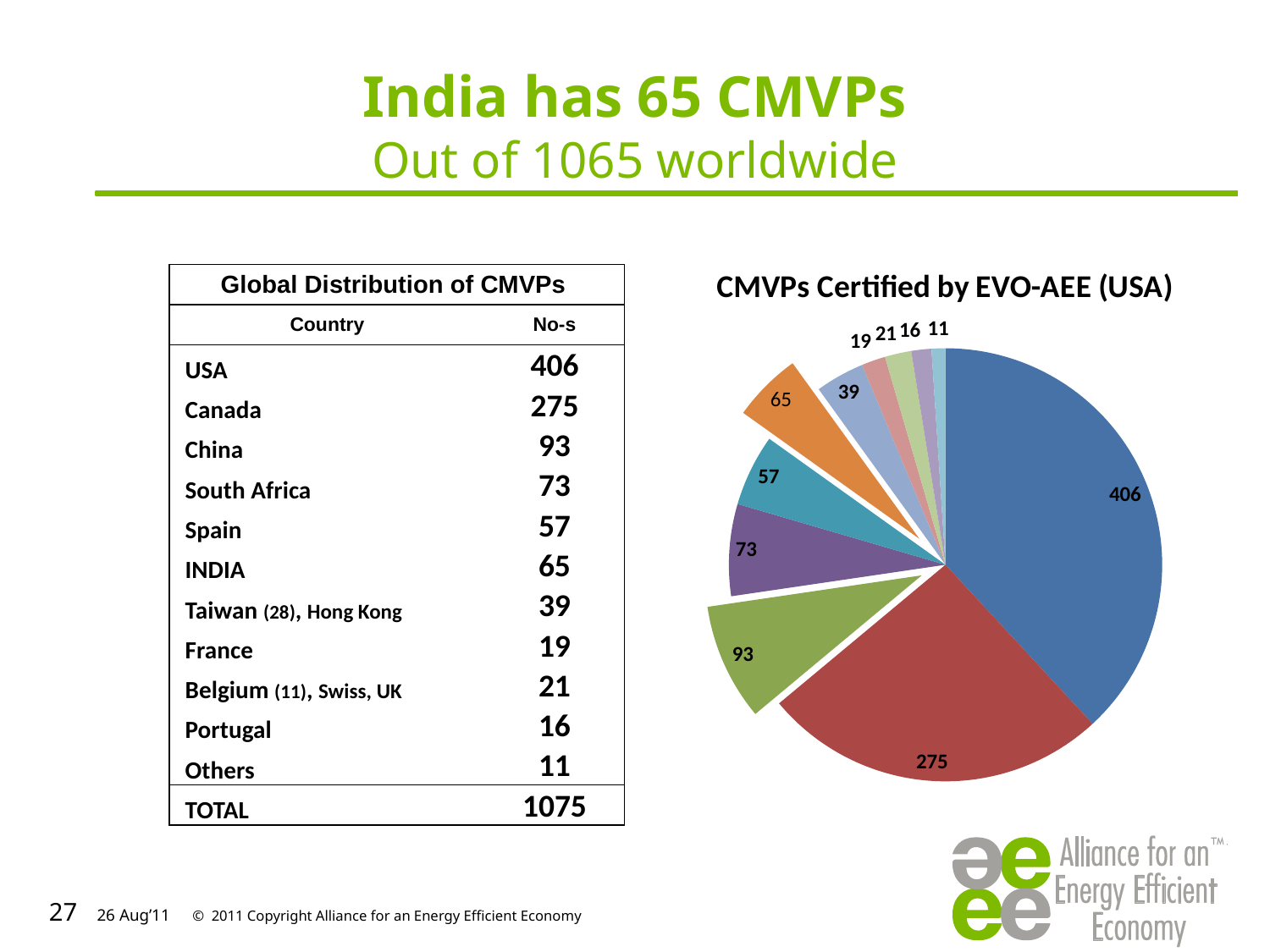
What is the value of the largest slice in the pie chart? 406 What kind of chart is shown on the slide? pie chart How many slices does the pie chart have? 11 What is the value of the second-largest slice in the pie chart? 275 What is the value of the smallest slice in the pie chart? 11 What is the difference between the slices labelled 65 and 57 in the pie chart? 8 What share of the pie does the slice labelled 406 represent, to one decimal place? 37.8% What is the title of the pie chart? CMVPs Certified by EVO-AEE (USA) What is the total of all slice values in the pie chart? 1075 Which slice is larger in the pie chart, the one labelled 93 or the one labelled 73? 93 What is the difference between the two largest slices in the pie chart (406 and 275)? 131 What colour is the largest slice (406) in the pie chart? blue